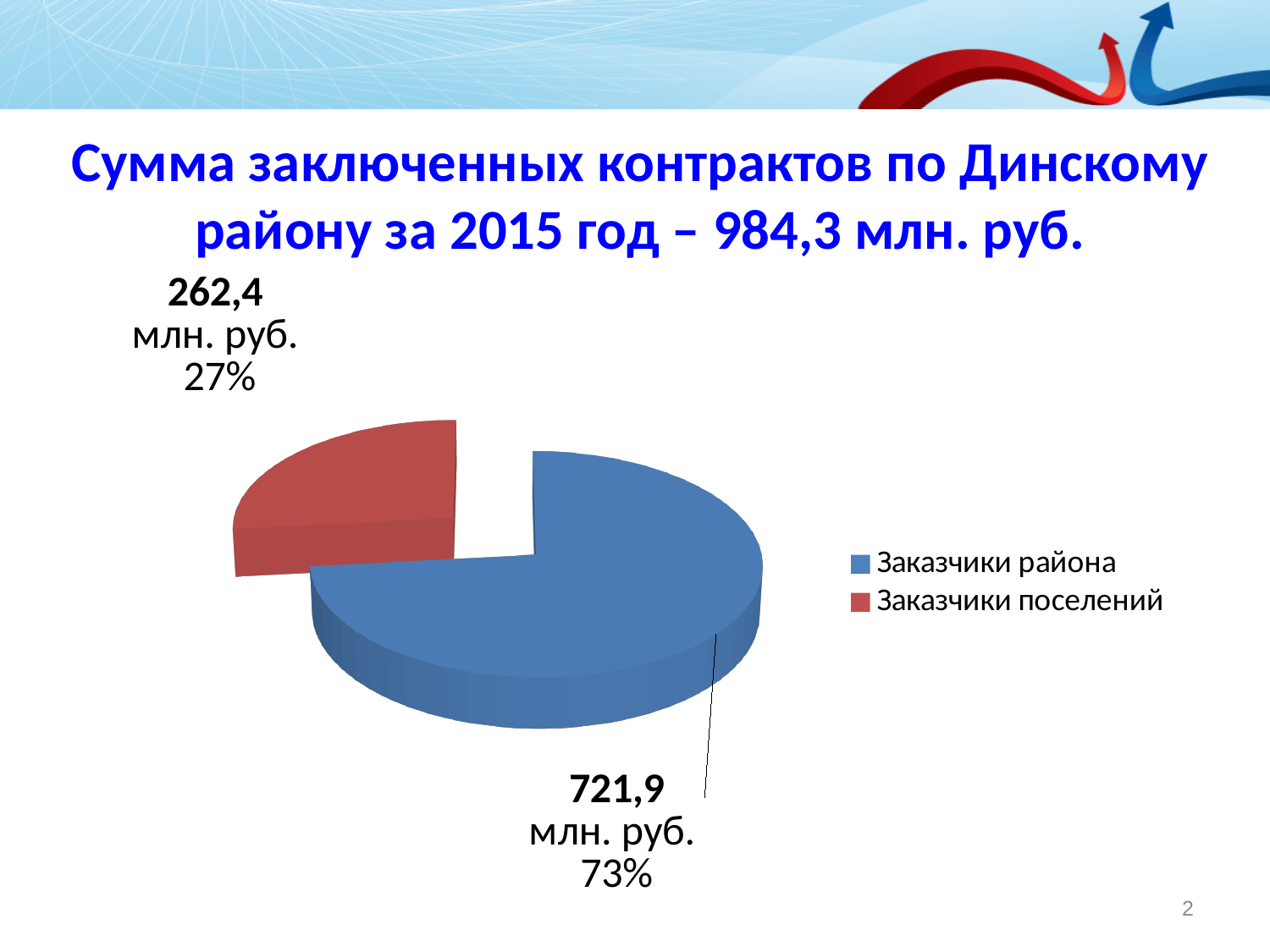
What is the difference between the values for Заказчики района and Заказчики поселений? 459,5 млн. руб. What is the value for Заказчики поселений? 262,4 млн. руб. What share of the pie does Заказчики поселений represent? 27% What colour is the slice for Заказчики поселений? red What share of the pie does Заказчики района represent? 73% Which is larger, the value for Заказчики района or for Заказчики поселений? Заказчики района How many entries does the legend list? 2 What is the value for Заказчики района? 721,9 млн. руб. Which category has the largest slice of the pie? Заказчики района How many slices does the pie chart have? 2 Which category has the smallest slice of the pie? Заказчики поселений What kind of chart is shown on the slide? pie chart